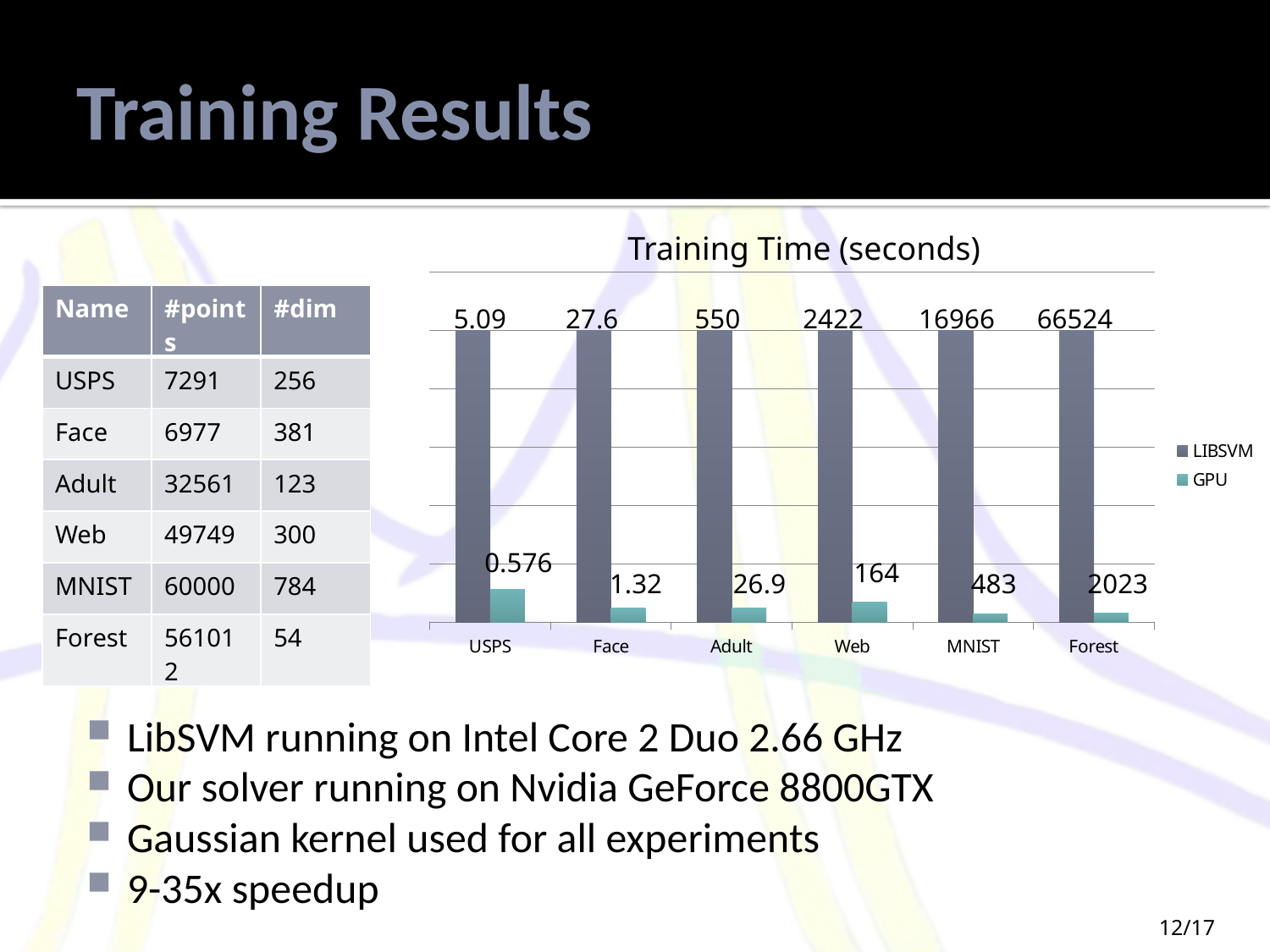
Which dataset has the lowest GPU training time? USPS What is the title of the chart? Training Time (seconds) How many datasets are shown on the x axis of the chart? 6 What is the GPU training time for the MNIST dataset? 483 What kind of chart is used to show the training times? Bar chart What is the LIBSVM training time for the Web dataset? 2422 Which is larger: the GPU training time for Forest or the LIBSVM training time for Web? LIBSVM training time for Web What is the difference between the LIBSVM and GPU training times for the Web dataset? 2258 Which dataset has the highest LIBSVM training time? Forest How many series does the chart's legend list? 2 What is the GPU training time for the USPS dataset? 0.576 What is the difference between the LIBSVM and GPU training times for the Forest dataset? 64501